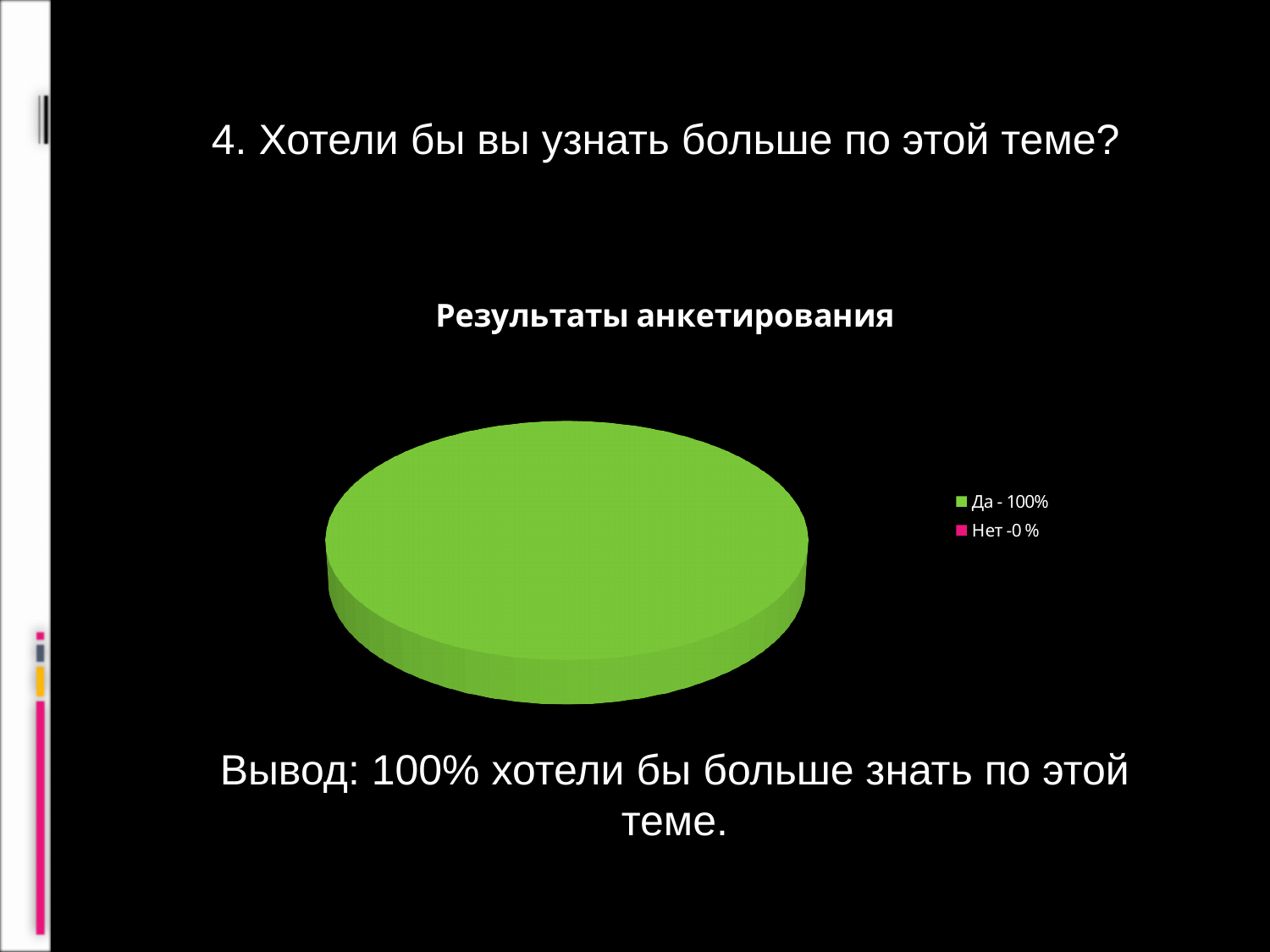
Which is larger, the share for "Да" or the share for "Нет"? Да What is the title of the chart? Результаты анкетирования Which category has the smallest share of the pie? Нет How many entries does the chart legend list? 2 How many categories are listed in the chart legend? 2 What colour represents "Да" in the chart? green Which category has the largest share of the pie? Да What is the difference between the share for "Да" and the share for "Нет"? 100% What share of the pie does "Да" take? 100% What share of the pie does "Нет" take? 0 % What kind of chart is shown on the slide? pie chart